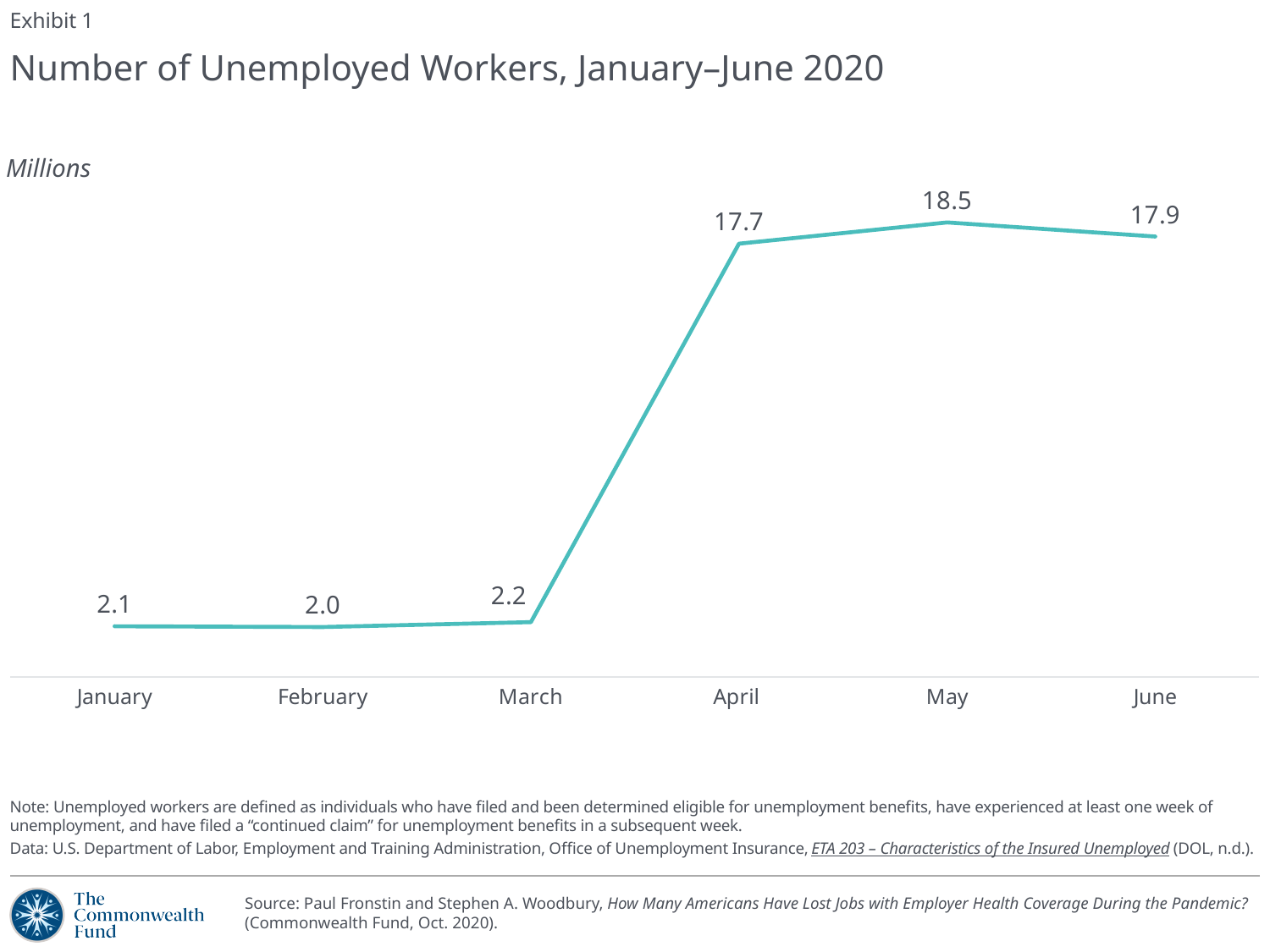
Which month has the lowest number of unemployed workers? February Which month has the highest number of unemployed workers? May What is the number of unemployed workers (in millions) in April? 17.7 What kind of chart is shown? Line chart What is the number of unemployed workers (in millions) in June? 17.9 Does the number of unemployed workers rise or fall between March and April? Rise What is the number of unemployed workers (in millions) in February? 2.0 Which month has a larger value, March or June? June How many months are plotted on the chart? 6 What is the difference in millions between the May and April values? 0.8 What is the difference in millions between the March and January values? 0.1 What unit is the chart's vertical axis labeled in? Millions